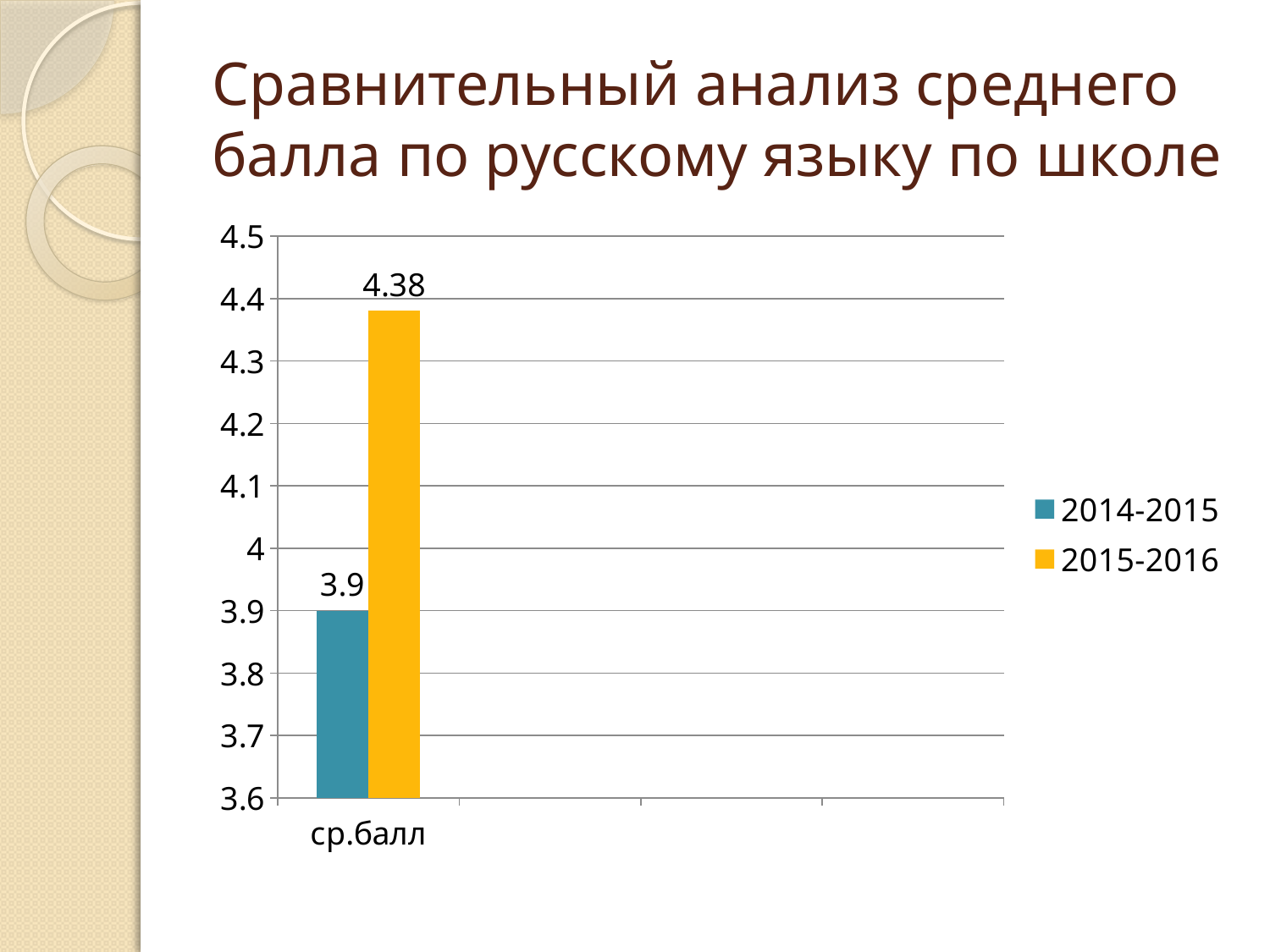
Which series has the lowest value on the chart? 2014-2015 Is the value for 2014-2015 greater or less than 4? less Is the value for 2015-2016 greater or less than 4.3? greater What is the difference between the 2015-2016 and 2014-2015 values? 0.48 What kind of chart is shown on the slide? bar chart How many categories are shown on the x axis? 1 What colour is the bar for the 2015-2016 series? yellow How many series does the legend list? 2 What is the value for 2014-2015 in the ср.балл category? 3.9 What is the value for 2015-2016 in the ср.балл category? 4.38 What is the label of the category on the x axis? ср.балл Which series has the higher value for ср.балл, 2014-2015 or 2015-2016? 2015-2016